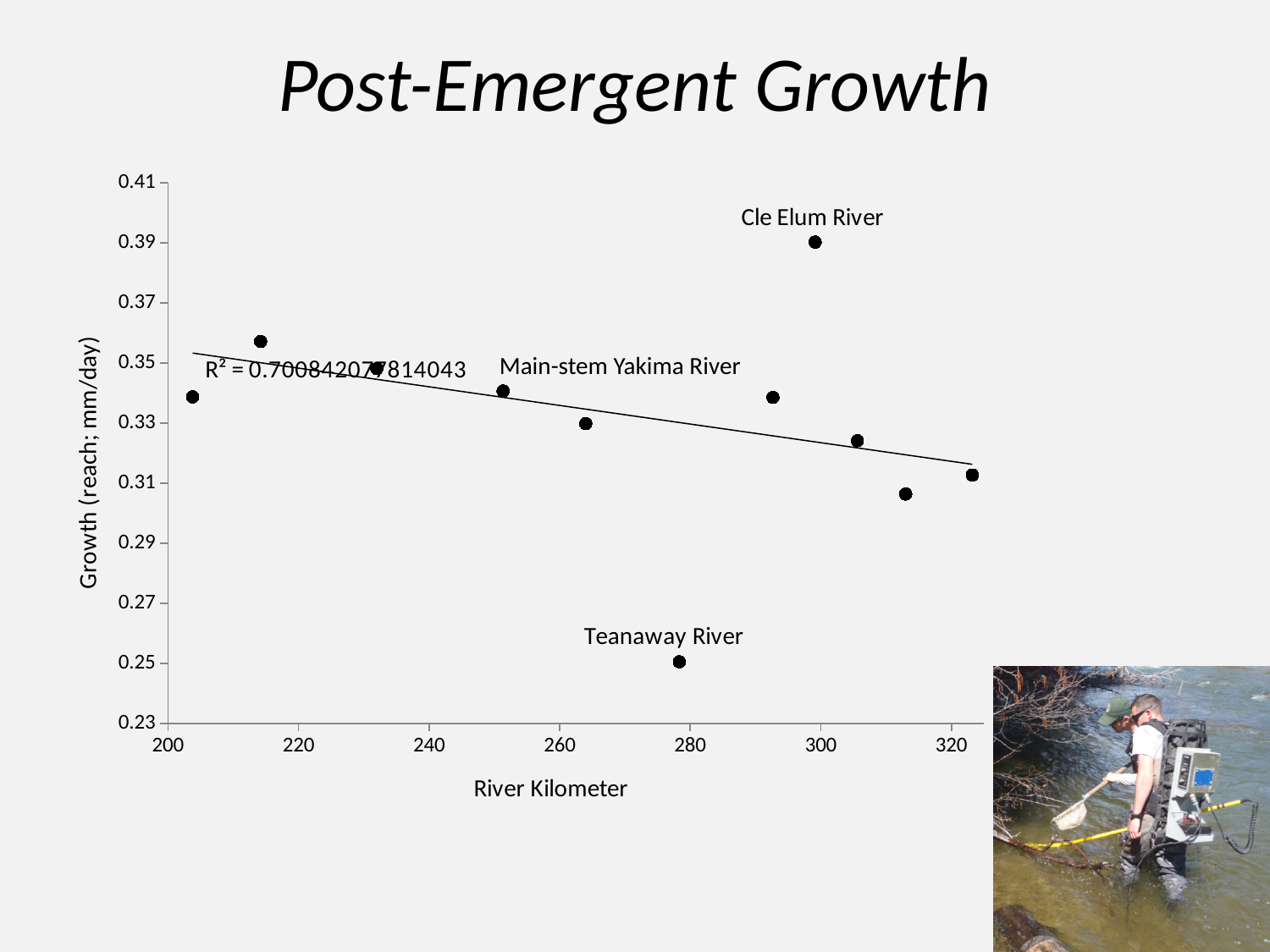
What is the title of the x axis? River Kilometer Which labeled river has the highest growth value on the chart? Cle Elum River How many data points are plotted on the chart? 11 What kind of chart is shown on the slide? scatter plot Does the trend line show growth rising or falling as river kilometer increases? falling Is the growth value for Teanaway River greater or less than 0.27? less Is the growth value for Cle Elum River greater or less than 0.37? greater Is the growth value for the point at about river kilometer 214 greater or less than 0.35? greater Which has the larger growth value, Cle Elum River or Teanaway River? Cle Elum River What is the title of the y axis? Growth (reach; mm/day) Which labeled river has the lowest growth value on the chart? Teanaway River